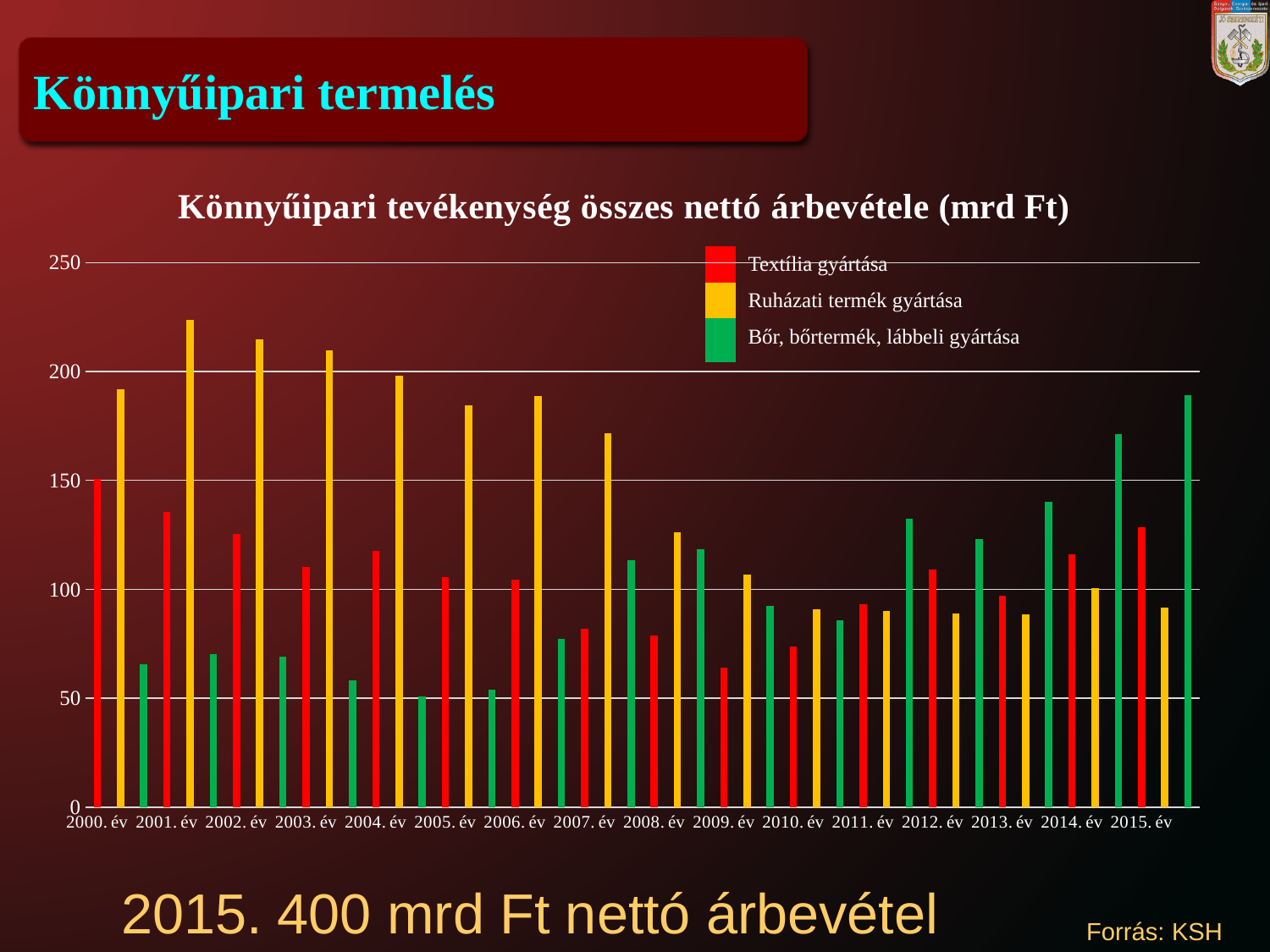
In 2000. év, which is larger: Textília gyártása or Ruházati termék gyártása? Ruházati termék gyártása Is the value for Bőr, bőrtermék, lábbeli gyártása in 2015. év greater or less than 150? greater Which colour represents Bőr, bőrtermék, lábbeli gyártása in the legend? green In which year is Bőr, bőrtermék, lábbeli gyártása highest? 2015. év Is the value for Textília gyártása in 2009. év greater or less than 100? less In which year is Textília gyártása lowest? 2009. év What is the title of the chart? Könnyűipari tevékenység összes nettó árbevétele (mrd Ft) How many years are shown on the x axis? 16 What kind of chart is shown on the slide? bar chart How many series does the legend list? 3 Is the value for Ruházati termék gyártása in 2001. év greater or less than 200? greater Does Ruházati termék gyártása rise or fall from 2003. év to 2011. év? fall